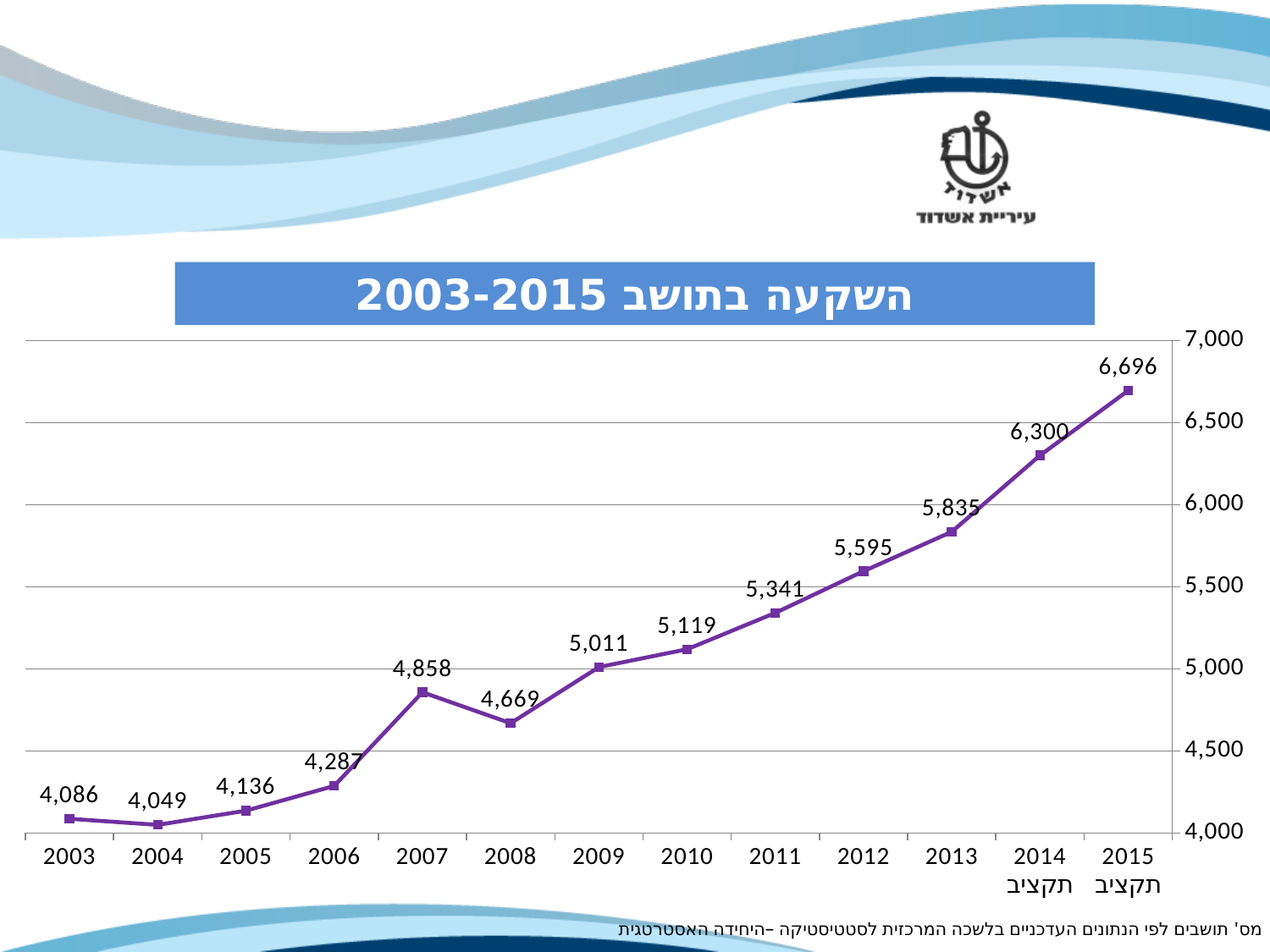
What is the difference between the values for 2015 and 2003? 2,610 Which year has the lowest value? 2004 Which year has the highest value? 2015 What is the difference between the values for 2007 and 2008? 189 What is the value for 2009? 5,011 How many years are plotted on the chart? 13 What kind of chart is shown on the slide? line chart What is the title of the chart? השקעה בתושב 2003-2015 What is the value for 2003? 4,086 What is the value for 2014? 6,300 Which is larger, the value for 2007 or the value for 2008? 2007 Is the value for 2012 greater or less than 5,500? greater